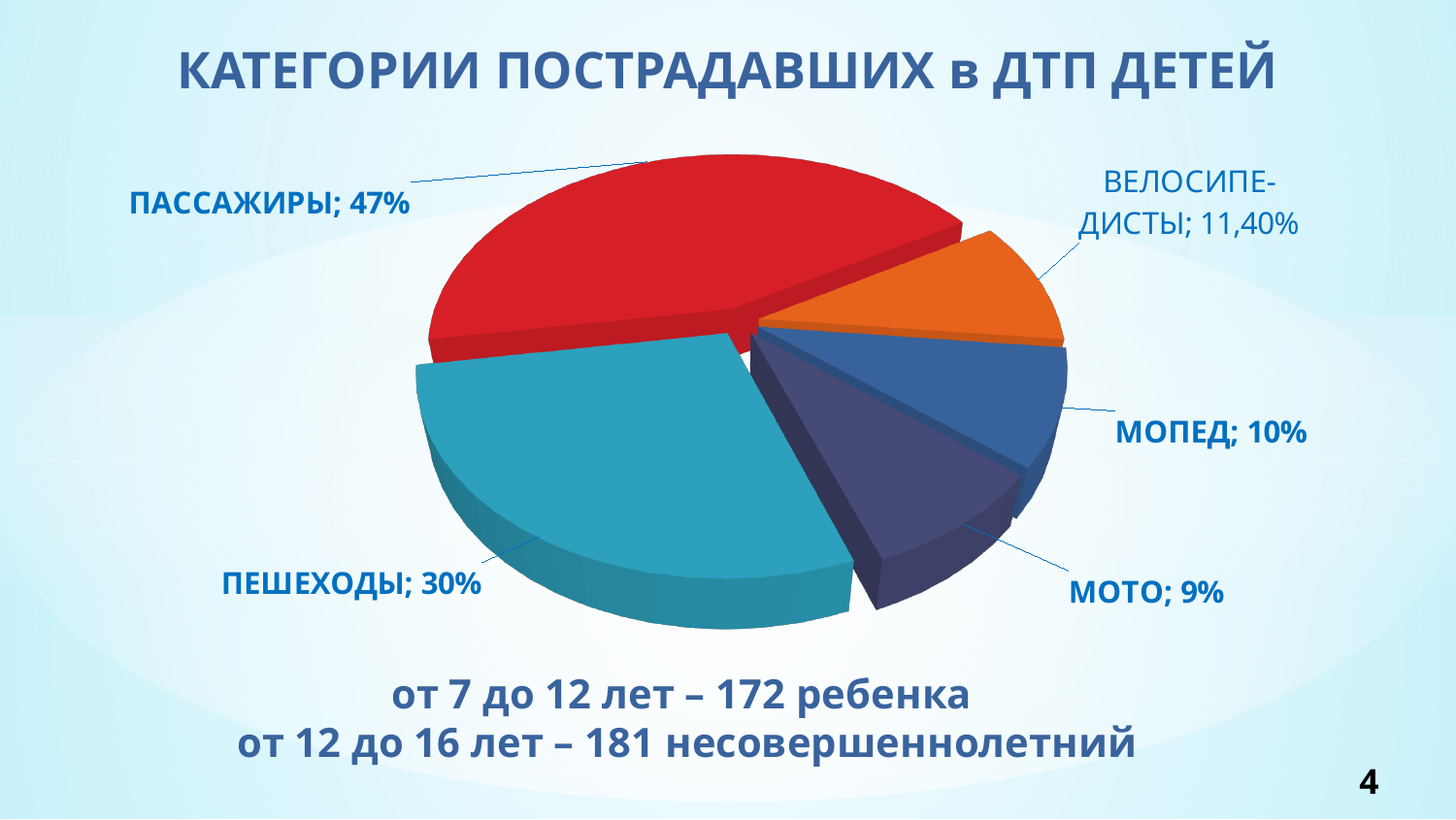
What value is shown for МОПЕД? 10% Which category has the smallest share of the pie? МОТО What value is shown for ПЕШЕХОДЫ? 30% What value is shown for ВЕЛОСИПЕДИСТЫ? 11,40% What kind of chart is shown on the slide? Pie chart How many categories are shown in the pie chart? 5 What is the title of the chart on the slide? КАТЕГОРИИ ПОСТРАДАВШИХ в ДТП ДЕТЕЙ Which category has the largest share of the pie? ПАССАЖИРЫ What value is shown for МОТО? 9% What share of the pie does ПАССАЖИРЫ have? 47% What is the difference between the shares of ПАССАЖИРЫ and ПЕШЕХОДЫ? 17% Which is larger, the share of ПЕШЕХОДЫ or the share of ВЕЛОСИПЕДИСТЫ? ПЕШЕХОДЫ